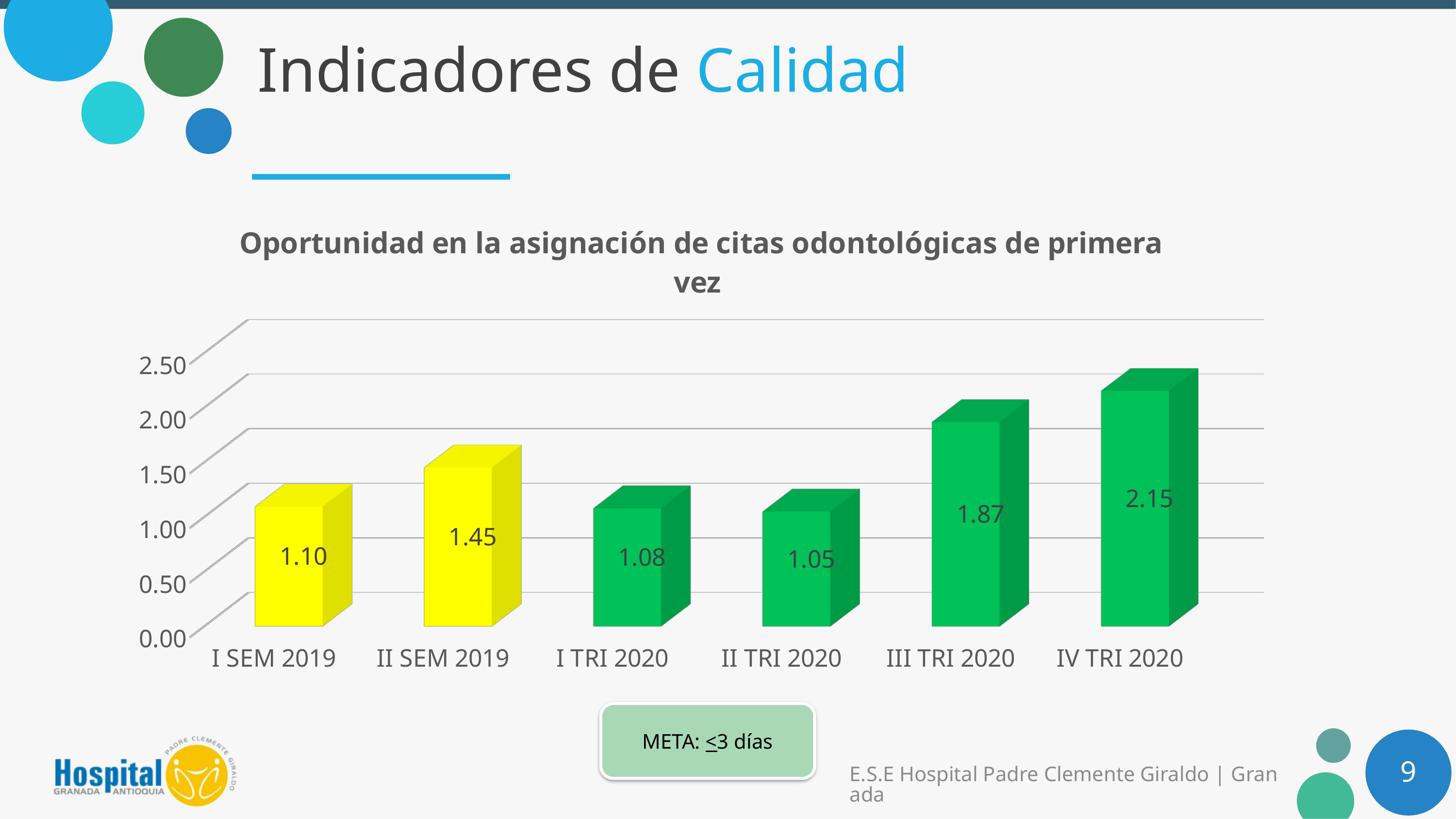
Which category has the highest value? IV TRI 2020 What is the title of the chart? Oportunidad en la asignación de citas odontológicas de primera vez Which is larger, the value for II SEM 2019 or the value for I TRI 2020? II SEM 2019 What kind of chart is shown on the slide? bar chart Which category has the lowest value? II TRI 2020 What is the difference between the values for IV TRI 2020 and III TRI 2020? 0.28 Is the value for III TRI 2020 greater or less than 1.50? greater How many categories are shown on the x axis? 6 What is the value for I SEM 2019? 1.10 What is the value for II TRI 2020? 1.05 What is the value for IV TRI 2020? 2.15 What colour are the bars for the 2019 categories? yellow